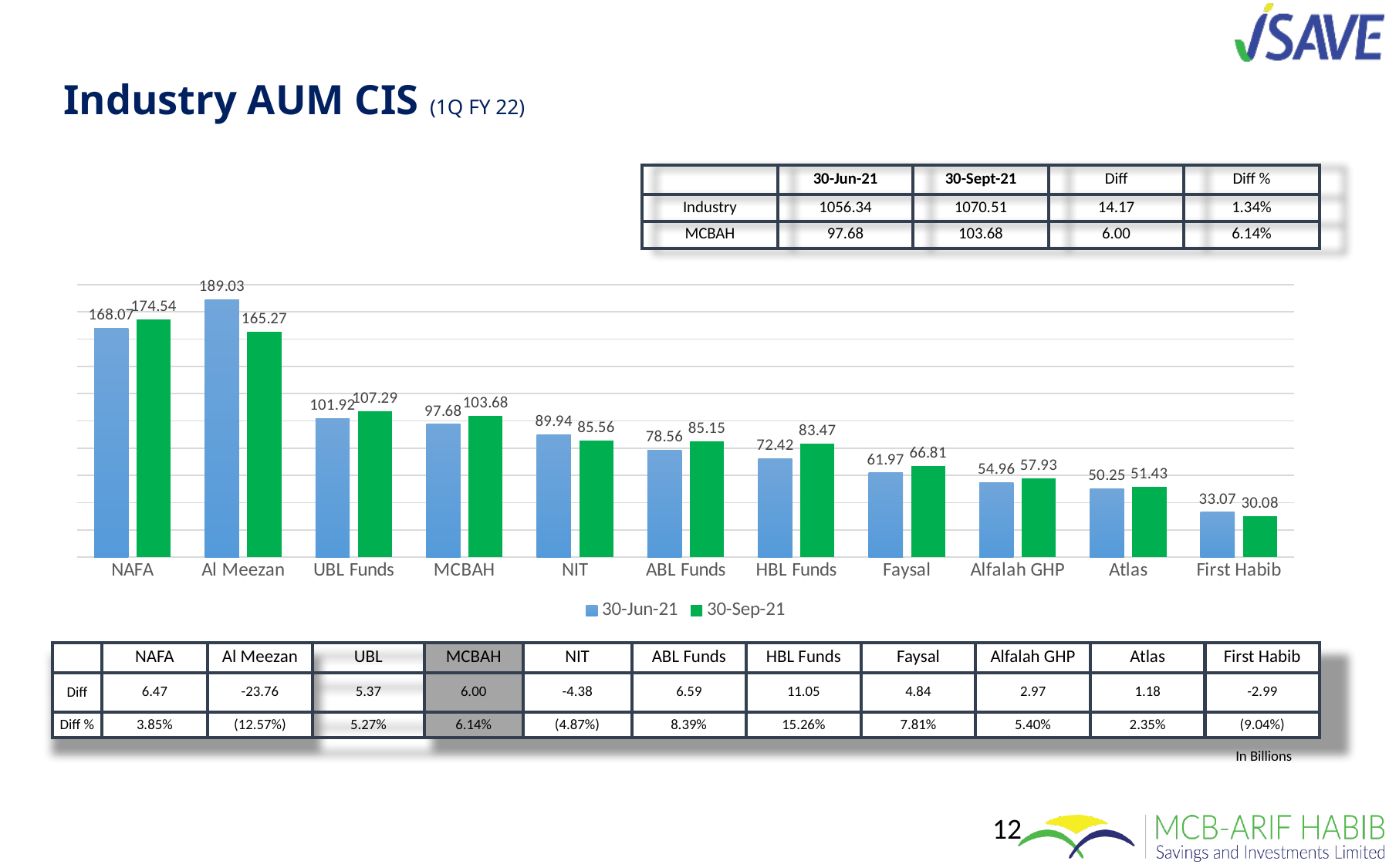
What is the 30-Jun-21 value for Al Meezan? 189.03 Which category has the lowest 30-Sep-21 value? First Habib How many categories are shown on the x axis of the chart? 11 Which category has the highest 30-Sep-21 value? NAFA Which category has the highest 30-Jun-21 value? Al Meezan What is the 30-Sep-21 value for HBL Funds? 83.47 By how much did Al Meezan's value fall from 30-Jun-21 to 30-Sep-21? 23.76 What kind of chart is shown on the slide? Bar chart What is the difference between the 30-Sep-21 and 30-Jun-21 values for NAFA? 6.47 What is the 30-Sep-21 value for MCBAH? 103.68 How many series does the chart legend list? 2 Which is larger for NIT: the 30-Jun-21 value or the 30-Sep-21 value? 30-Jun-21